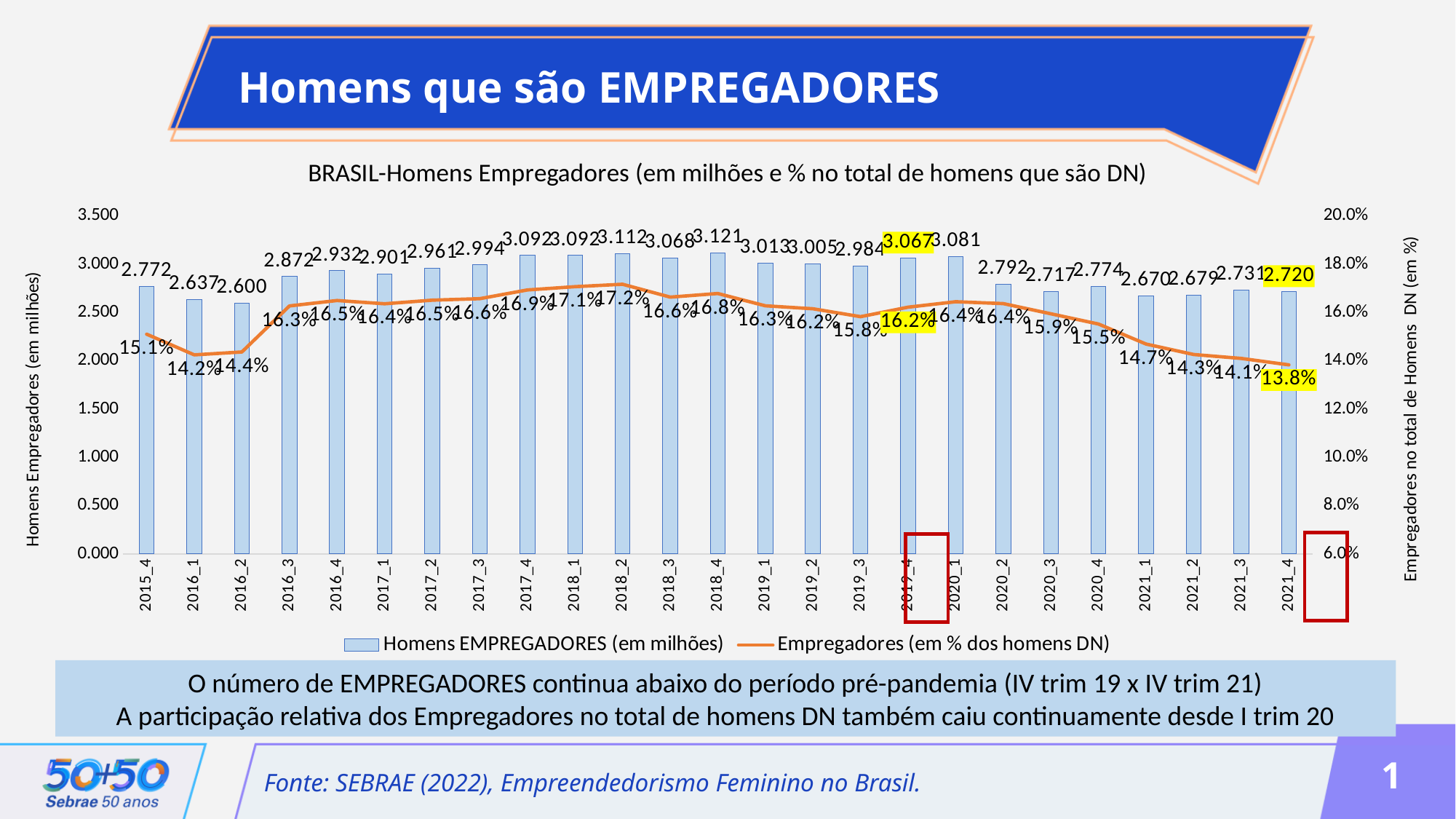
What is the highest value reached by the Empregadores (em % dos homens DN) line? 17.2% Does the Empregadores (em % dos homens DN) line rise or fall from 2020_1 to 2021_4? Fall How many quarters are shown on the x axis of the chart? 25 What is the value of Homens EMPREGADORES (em milhões) for 2016_2? 2.600 What percentage of homens DN were Empregadores in 2019_4? 16.2% Which quarter has more Homens EMPREGADORES (em milhões): 2020_1 or 2020_2? 2020_1 How many series does the chart legend list? 2 What kind of chart is shown on the slide? Combined bar and line chart What is the value of Homens EMPREGADORES (em milhões) for 2021_4? 2.720 What is the difference in Homens EMPREGADORES (em milhões) between 2019_4 and 2021_4? 0.347 In which quarter is the number of Homens EMPREGADORES (em milhões) highest? 2018_4 In which quarter is the Empregadores (em % dos homens DN) line at its lowest? 2021_4